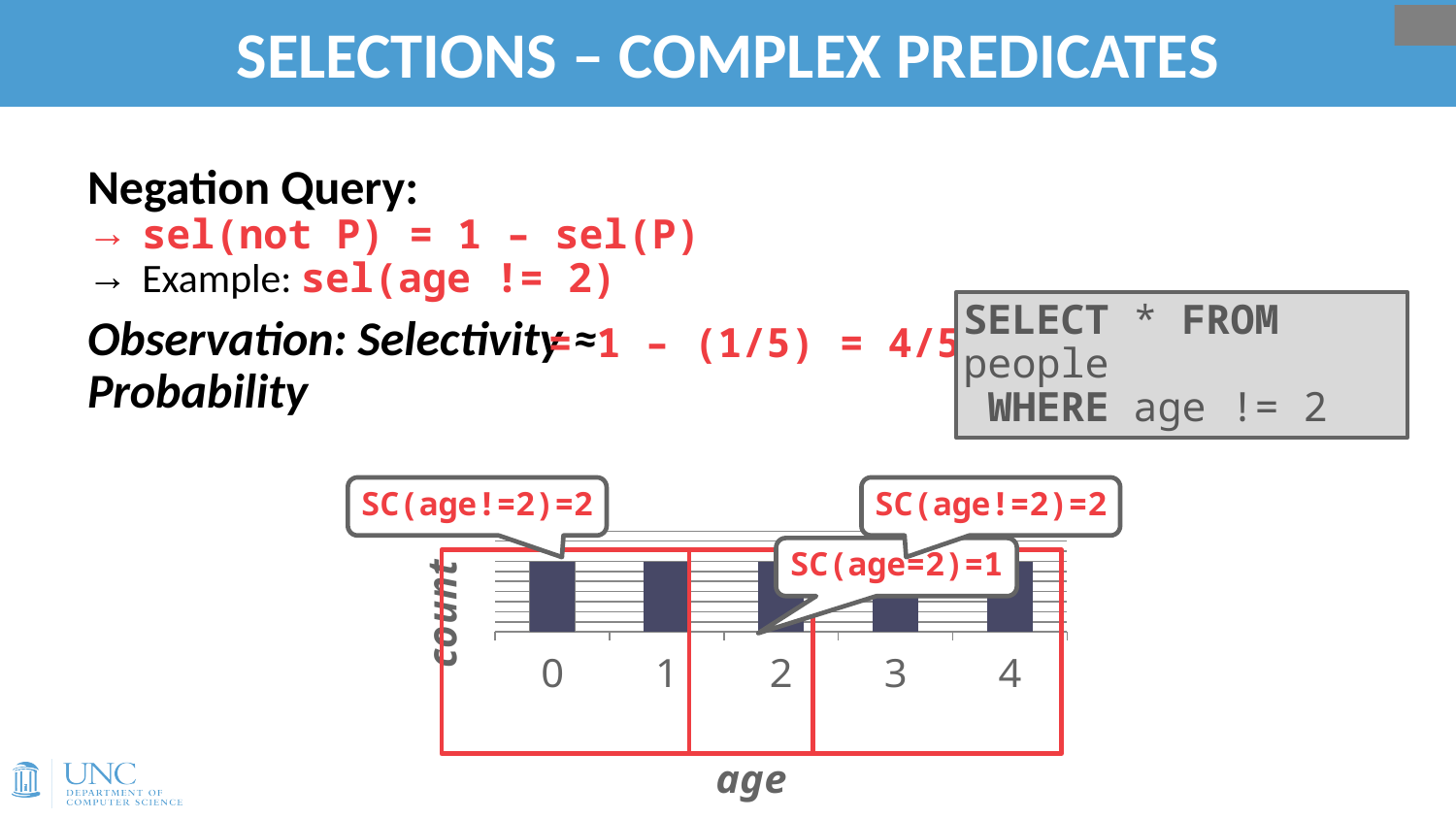
What is the label of the y axis of the chart? count How many age categories are shown on the x axis of the chart? 5 What is the label of the x axis of the chart? age What kind of chart is shown on the slide? bar chart According to the callout pointing at the age 2 bar, what is SC(age=2)? 1 What is the last age category shown on the x axis of the chart? 4 What is the first age category shown on the x axis of the chart? 0 According to the callout over the bars for ages 0 and 1, what is SC(age!=2) for that group? 2 According to the callout over the bars for ages 3 and 4, what is SC(age!=2) for that group? 2